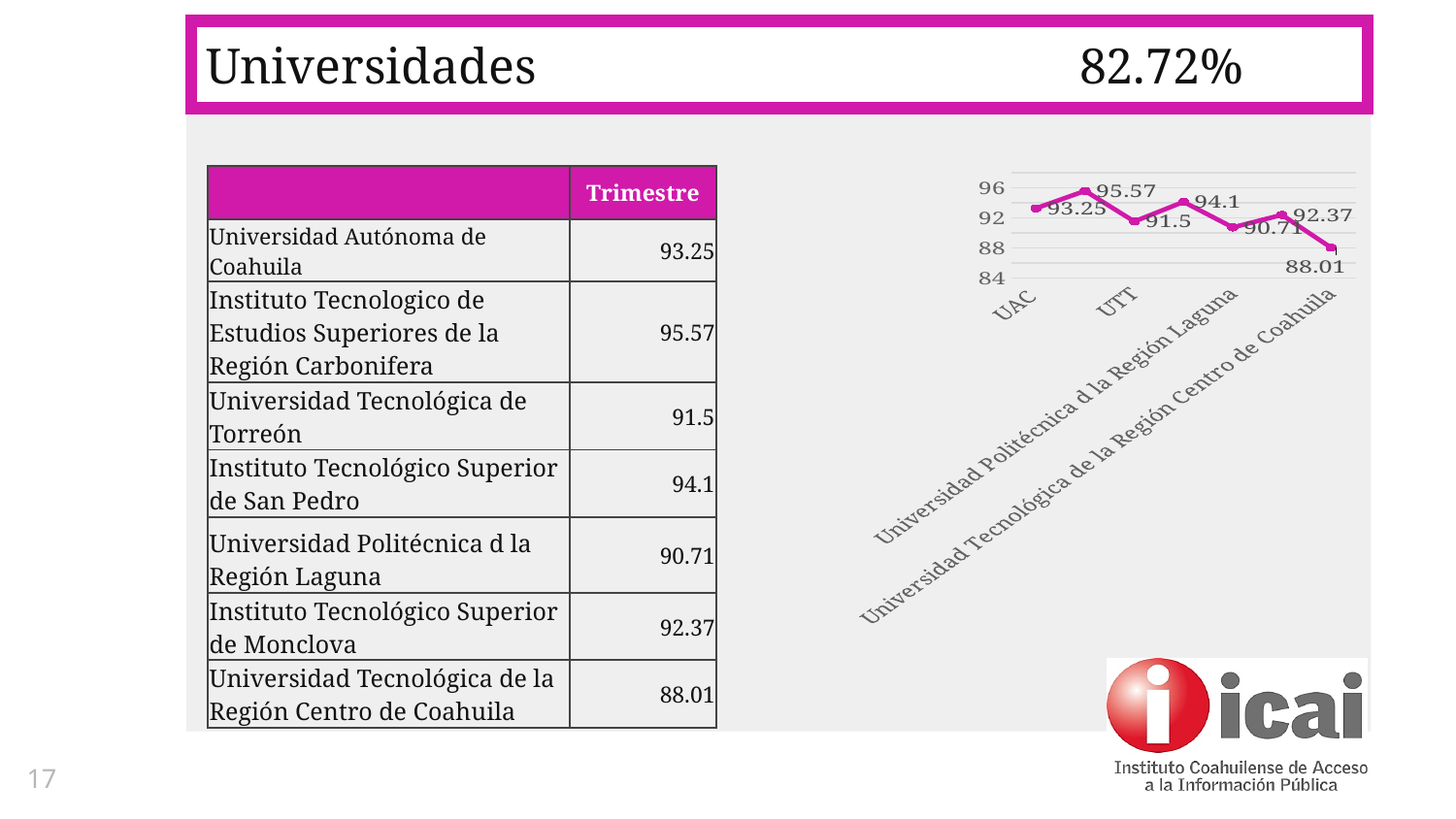
What is the highest value plotted in the chart? 95.57 Is the value for Universidad Tecnológica de la Región Centro de Coahuila greater or less than 92? less What type of chart is shown on the slide? line chart What is the value plotted for Universidad Tecnológica de la Región Centro de Coahuila in the chart? 88.01 What is the difference between the values for UAC and UTT in the chart? 1.75 How many data points are plotted in the chart? 7 Which category has the lowest value in the chart? Universidad Tecnológica de la Región Centro de Coahuila What is the value plotted for UAC in the chart? 93.25 What is the value plotted for Universidad Politécnica d la Región Laguna in the chart? 90.71 What is the value plotted for UTT in the chart? 91.5 Is the last point in the chart higher or lower than the first point? lower Which has the larger value in the chart, UAC or UTT? UAC